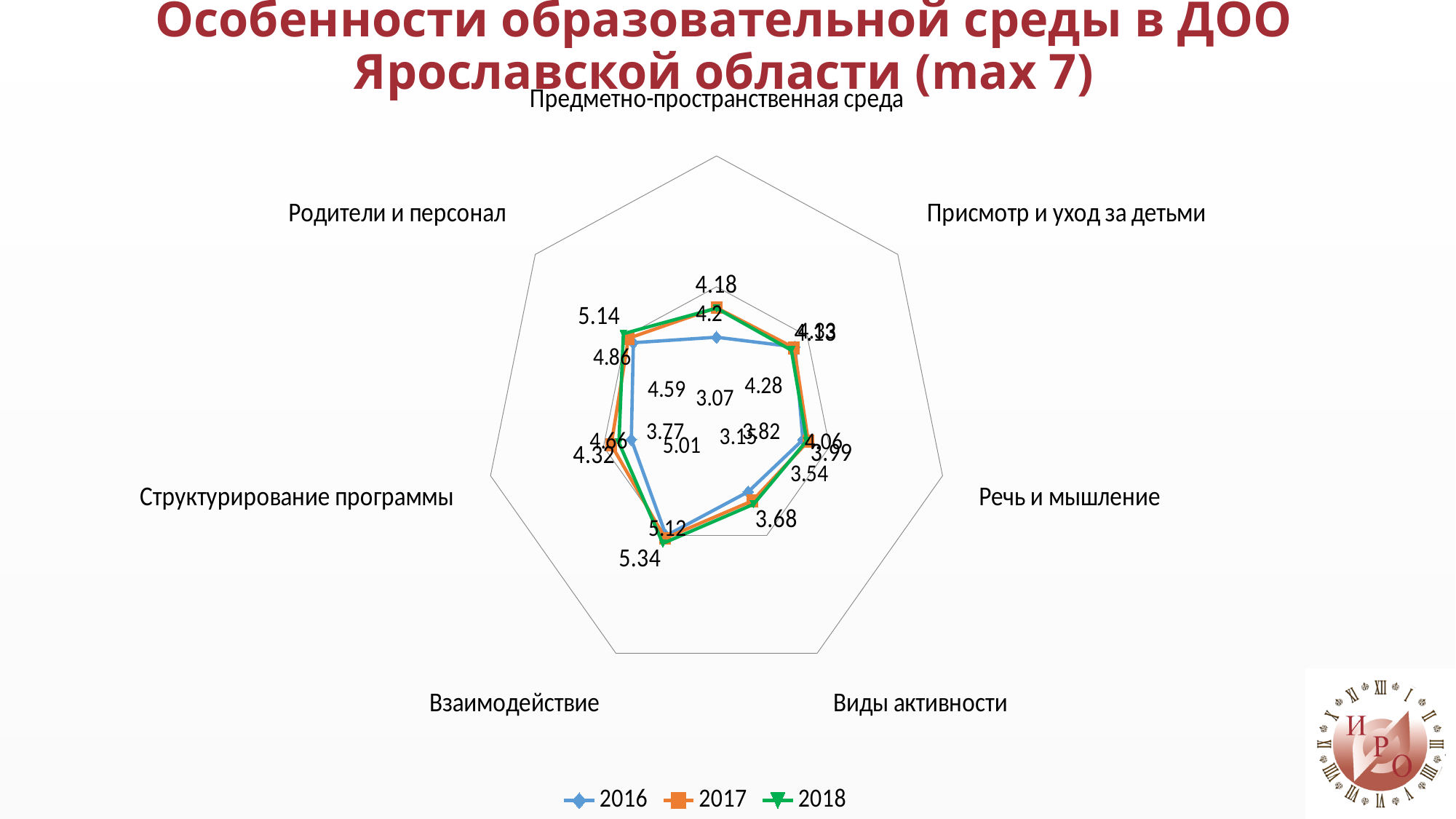
What is the maximum possible score mentioned in the slide title? 7 For 2016, which is larger: the value for Родители и персонал or the value for Структурирование программы? Родители и персонал Which category has the lowest 2016 value? Предметно-пространственная среда Which years are listed in the chart legend? 2016, 2017, 2018 What is the 2016 value for Виды активности? 3.15 Which category has the highest 2016 value? Взаимодействие What is the 2016 value for Взаимодействие? 5.01 How many categories (axes) does the radar chart have? 7 What is the difference between the 2016 values for Взаимодействие and Виды активности? 1.86 What kind of chart is shown on the slide? Radar chart How many series does the legend list? 3 What is the 2016 value for Предметно-пространственная среда? 3.07